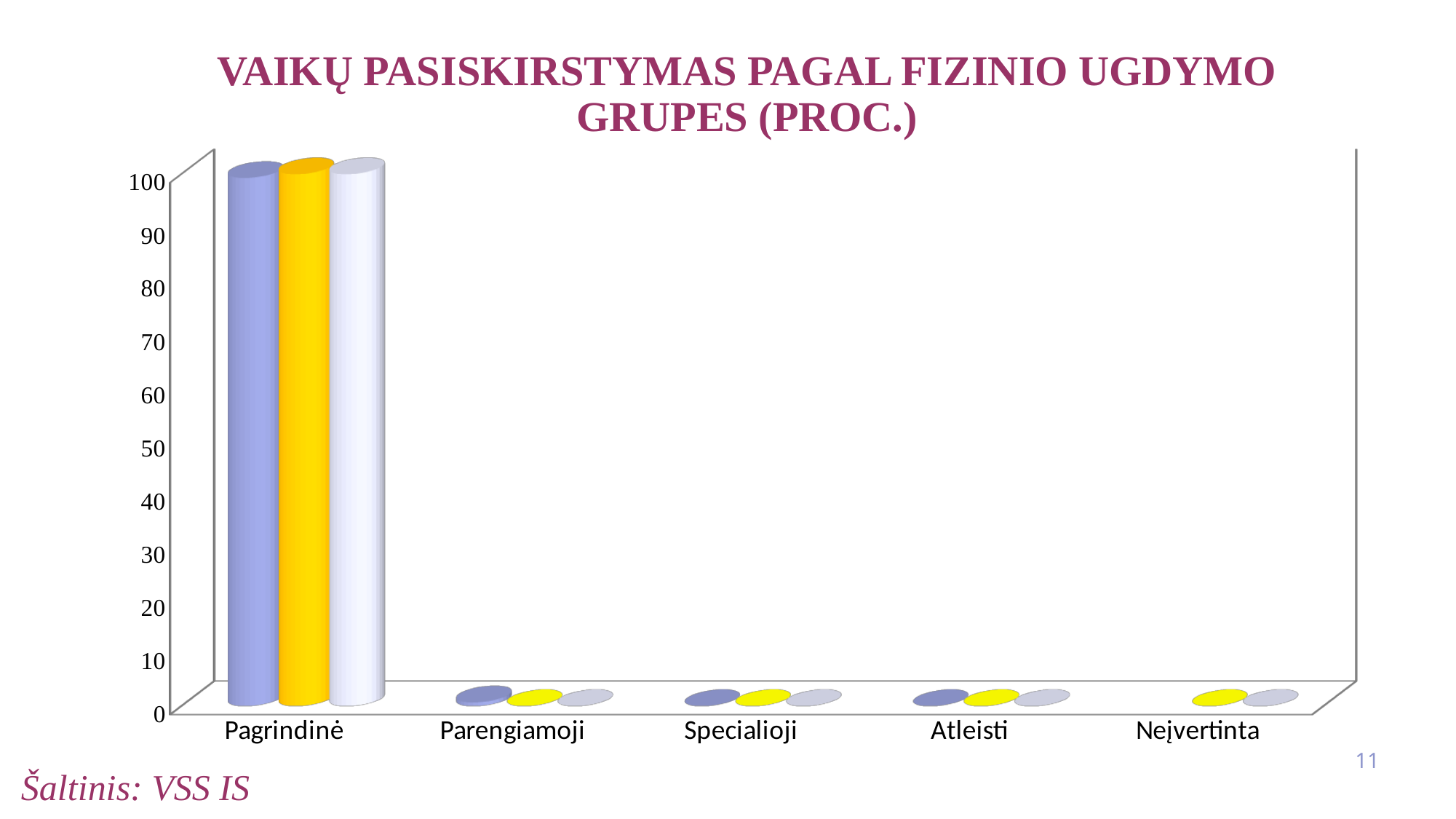
Are the values for Atleisti greater or less than 20? less What is the highest value shown on the y axis of the chart? 100 Which category has larger values, Pagrindinė or Specialioji? Pagrindinė Are the values for Parengiamoji greater or less than 10? less Which category has the highest values in the chart? Pagrindinė How many categories are shown on the x axis of the chart? 5 What kind of chart is shown on the slide? bar chart What is the title of the chart? VAIKŲ PASISKIRSTYMAS PAGAL FIZINIO UGDYMO GRUPES (PROC.) How many bars are plotted for the Pagrindinė category? 3 Do the values rise or fall from Pagrindinė to Parengiamoji? fall Are the values for Pagrindinė greater or less than 90? greater